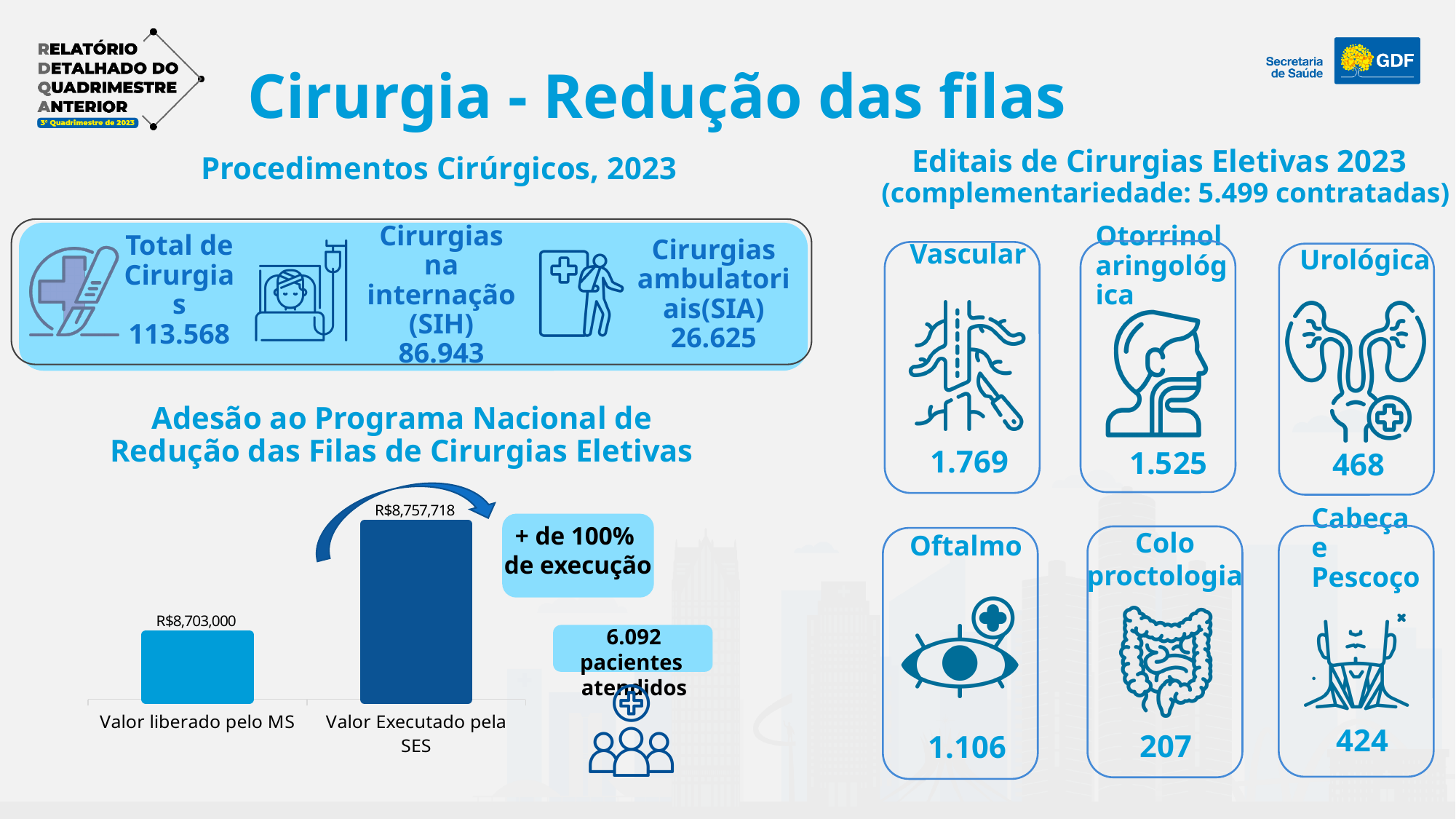
Do the values in the bar chart rise or fall from left to right? rise What is the difference between "Valor Executado pela SES" and "Valor liberado pelo MS" in the bar chart? R$54,718 What is the value for "Valor liberado pelo MS" in the bar chart? R$8,703,000 Which category in the bar chart has the lower value? Valor liberado pelo MS Which bar in the chart is the darker blue? Valor Executado pela SES Is the value for "Valor Executado pela SES" larger or smaller than the value for "Valor liberado pelo MS"? larger What kind of chart is shown on the slide? bar chart What is the heading printed above the bar chart? Adesão ao Programa Nacional de Redução das Filas de Cirurgias Eletivas Which category in the bar chart has the higher value? Valor Executado pela SES How many bars are shown in the bar chart? 2 What is the value for "Valor Executado pela SES" in the bar chart? R$8,757,718